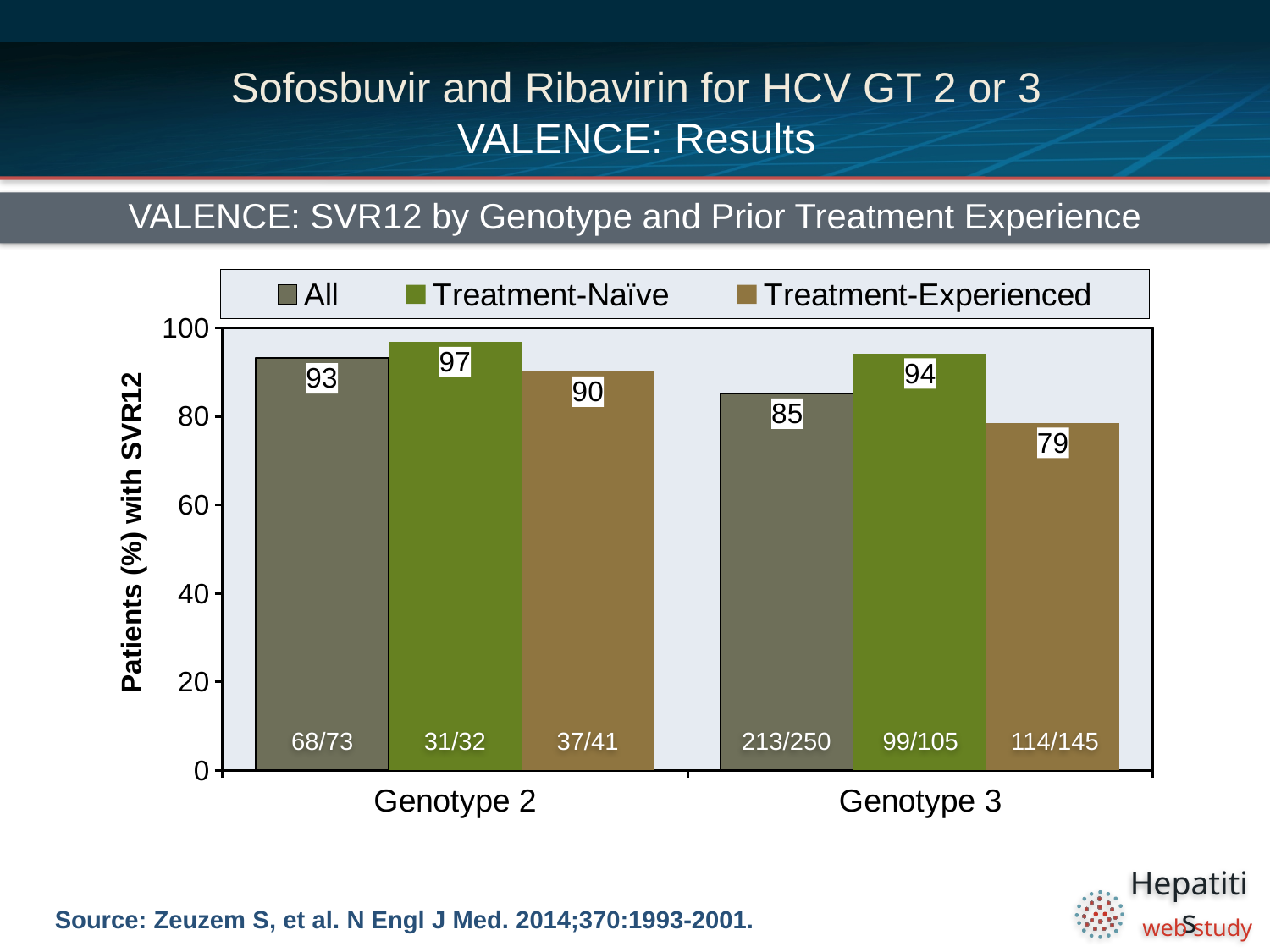
What is the SVR12 rate for Treatment-Naïve patients in Genotype 2? 97 What is the difference between the Treatment-Naïve and Treatment-Experienced SVR12 rates in Genotype 3? 15 Which series has the lowest SVR12 rate in Genotype 2? Treatment-Experienced What fraction of patients is printed on the Treatment-Naïve bar for Genotype 3? 99/105 Which is larger, the All SVR12 rate for Genotype 2 or for Genotype 3? Genotype 2 How many genotype categories are shown on the x axis? 2 What kind of chart is shown on the slide? bar chart What is the SVR12 rate for the All group in Genotype 2? 93 How many series does the legend list? 3 Is the Treatment-Experienced SVR12 rate for Genotype 3 greater or less than 80? less What is the SVR12 rate for Treatment-Experienced patients in Genotype 3? 79 Which series has the highest SVR12 rate in Genotype 3? Treatment-Naïve